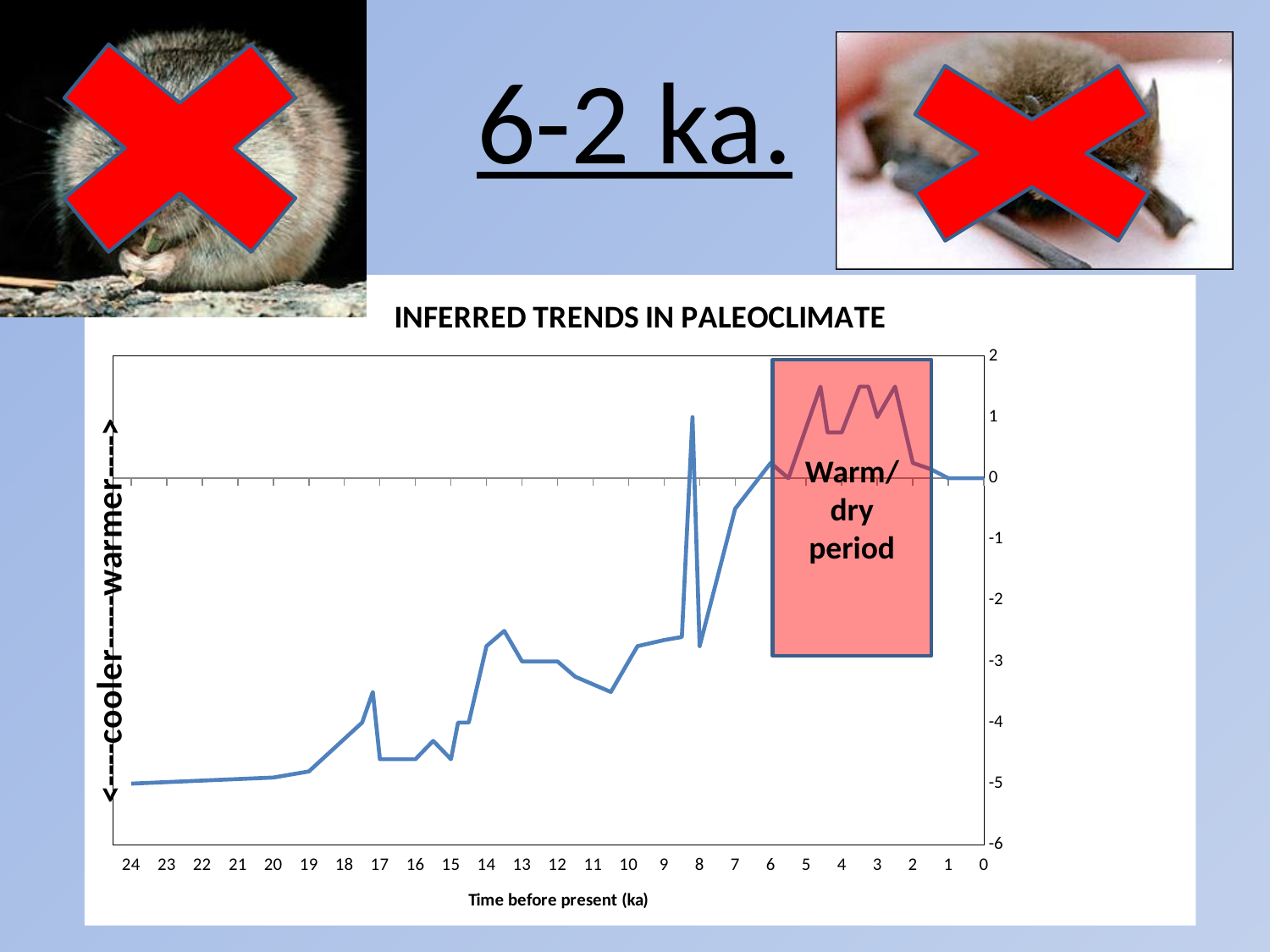
How many tick labels are shown on the x axis of the chart? 25 What is the title of the chart on the slide? INFERRED TRENDS IN PALEOCLIMATE Which is larger, the value at 4 ka or the value at 10 ka? 4 ka What kind of chart is shown under the title INFERRED TRENDS IN PALEOCLIMATE? Line chart Is the value at 14 ka greater or less than -4? greater Is the value at 17 ka greater or less than -3? less Is the value at 10 ka greater or less than -2? less Moving from 24 ka on the left to 0 ka on the right, do the plotted values generally rise or fall? rise What is the label of the x axis of the chart? Time before present (ka)